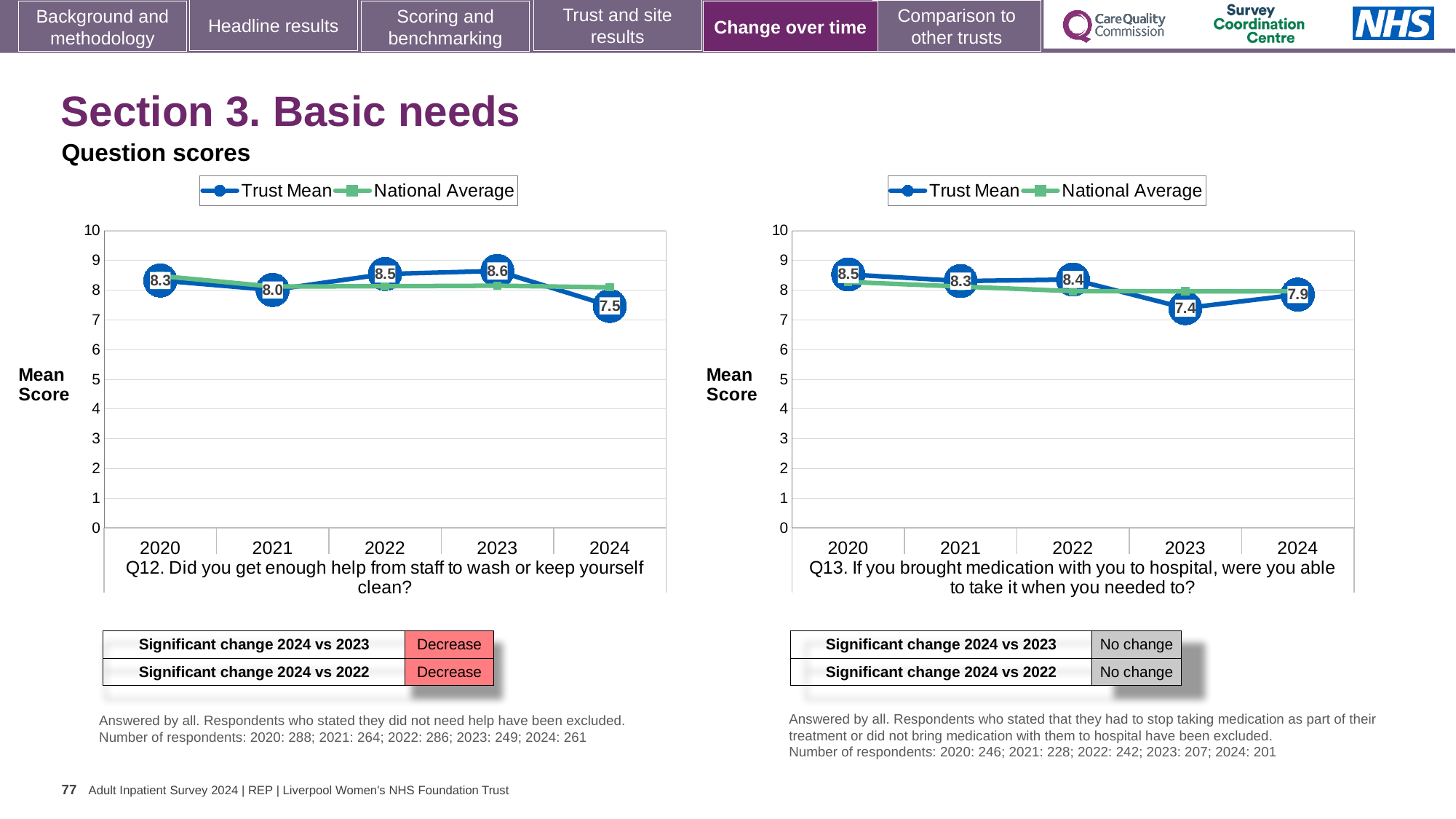
How many series does the legend of the Q12 chart (left) list? 2 In the Q13 chart (right), which year has the lowest Trust Mean? 2023 In the Q12 chart (left), which year has the highest Trust Mean? 2023 What kind of chart is the Q13 chart (right)? Line chart In the Q13 chart (right), what is the Trust Mean for 2023? 7.4 In the Q12 chart (left), what is the difference between the Trust Mean for 2023 and 2024? 1.1 In the Q13 chart (right), is the Trust Mean for 2022 or 2024 larger? 2022 In the Q12 chart (left), what is the Trust Mean for 2024? 7.5 In the Q12 chart (left), what is the Trust Mean for 2023? 8.6 In the Q13 chart (right), is the National Average for 2024 greater or less than 9? less In the Q12 chart (left), which year has the lowest Trust Mean? 2024 In the Q13 chart (right), what is the Trust Mean for 2020? 8.5